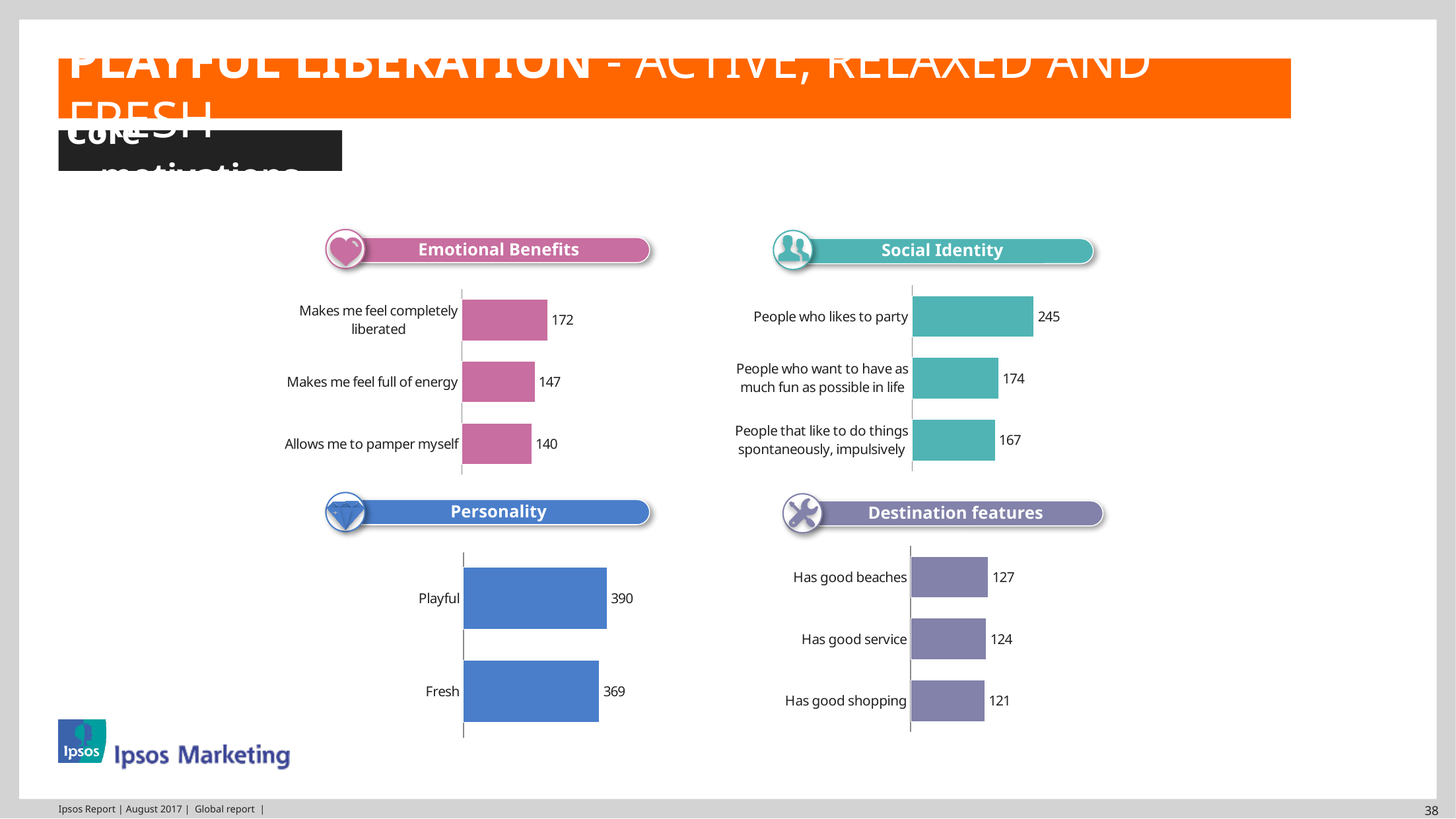
In the Social Identity chart, what is the value for "People who likes to party"? 245 In the Destination features chart, what is the difference between "Has good beaches" and "Has good shopping"? 6 In the Personality chart, how many categories are shown? 2 What kind of chart is the Destination features chart? Bar chart In the Emotional Benefits chart, which category has the lowest value? Allows me to pamper myself In the Social Identity chart, which category has the highest value? People who likes to party In the Personality chart, what is the value for Fresh? 369 In the Personality chart, which is larger, Playful or Fresh? Playful In the Emotional Benefits chart, what is the value for "Makes me feel completely liberated"? 172 In the Destination features chart, what is the value for "Has good service"? 124 In the Emotional Benefits chart, what is the difference between "Makes me feel full of energy" and "Allows me to pamper myself"? 7 In the Social Identity chart, what is the difference between "People who likes to party" and "People that like to do things spontaneously, impulsively"? 78